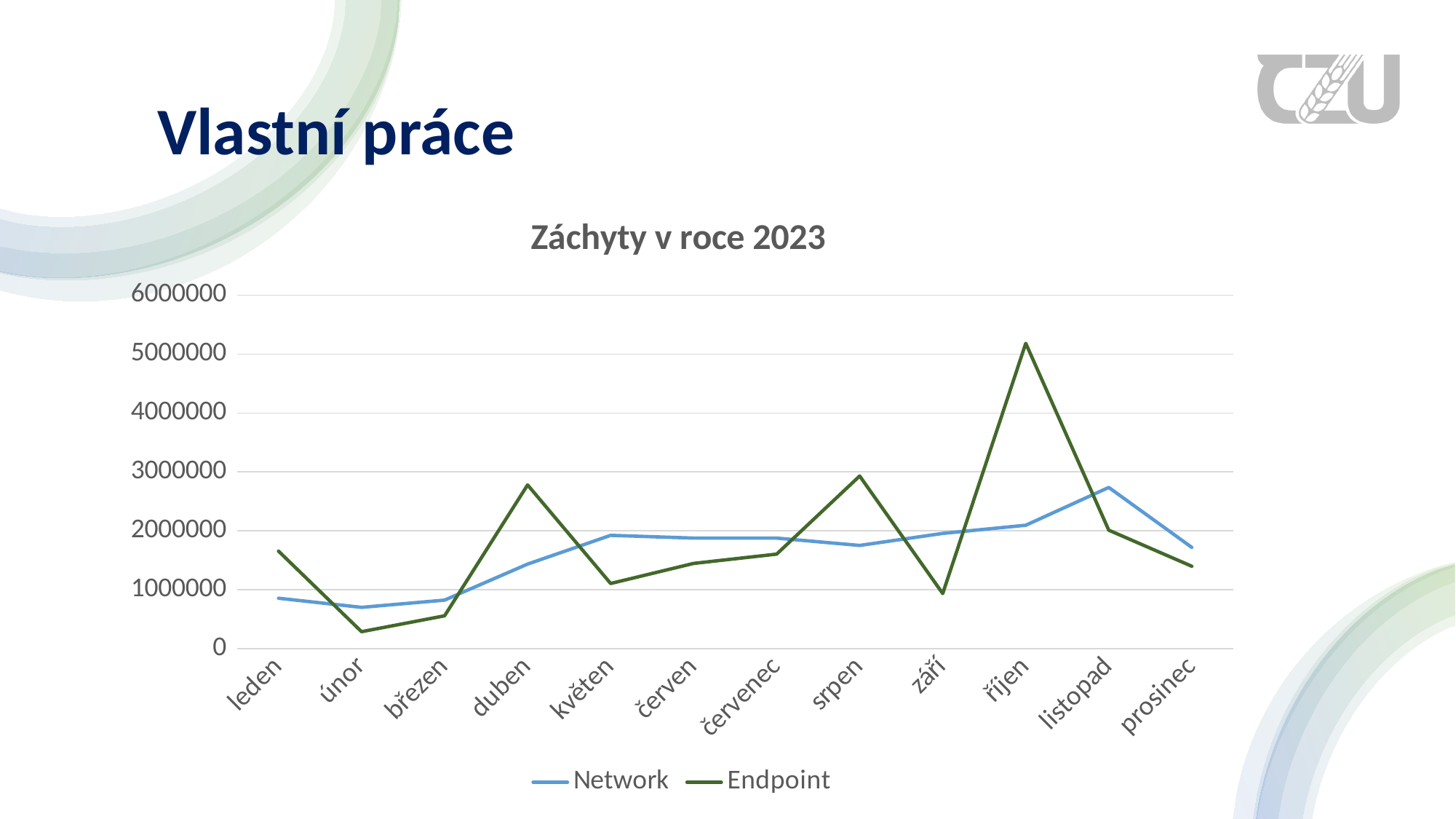
What kind of chart is shown on the slide? line chart In duben, which series has the larger value, Network or Endpoint? Endpoint What is the title of the chart? Záchyty v roce 2023 How many series does the legend list? 2 Is the Network value for leden greater or less than 1000000? less In which month does the Network series have its lowest value? únor How many months are plotted along the x axis? 12 Is the Endpoint value for říjen greater or less than 4000000? greater In which month does the Endpoint series reach its highest value? říjen In which month does the Endpoint series have its lowest value? únor In listopad, which series has the larger value, Network or Endpoint? Network In which month does the Network series reach its highest value? listopad